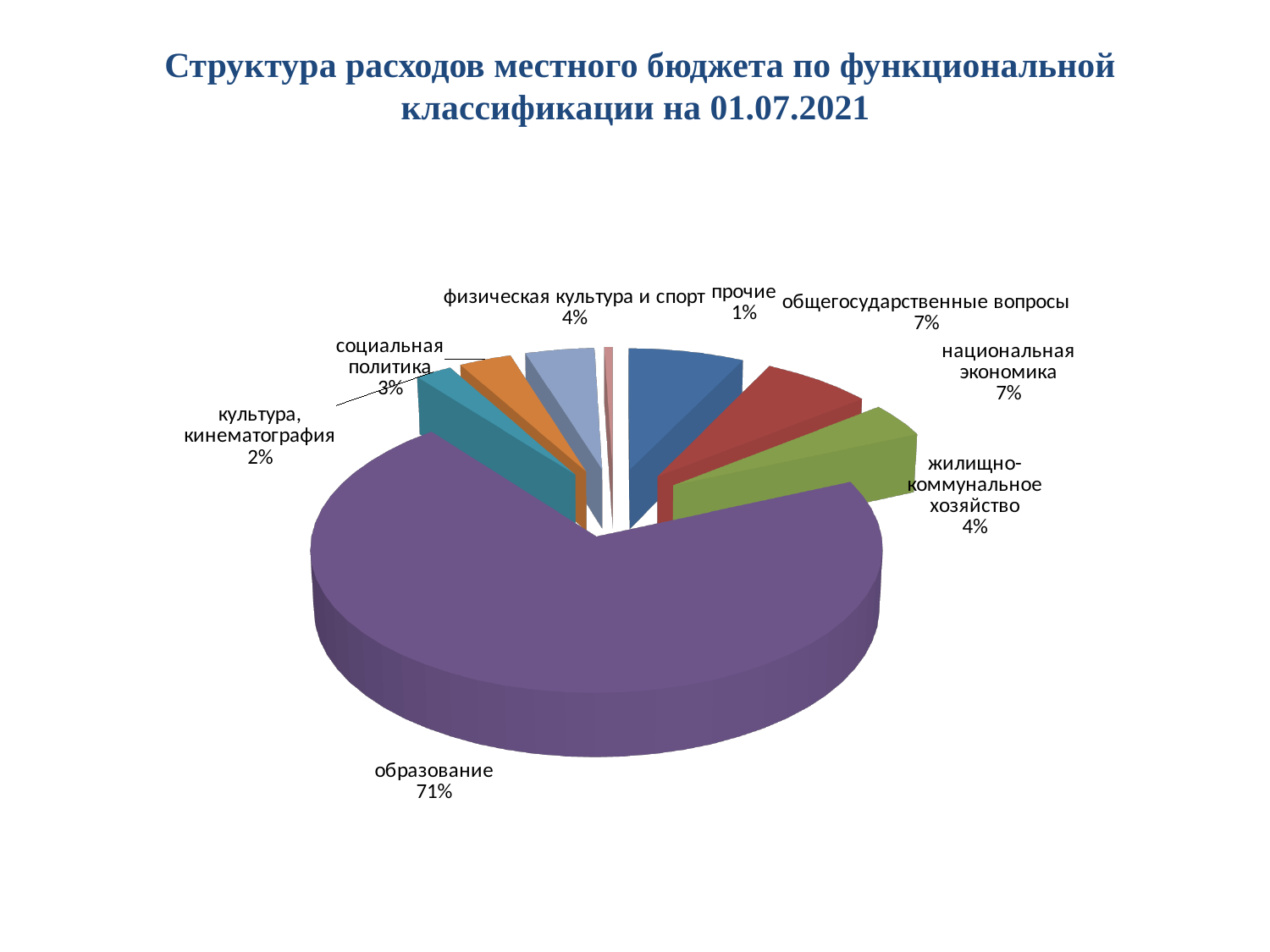
What is the difference in percentage points between образование and национальная экономика? 64 Which category has the largest share of the pie? образование What share of expenditures goes to социальная политика? 3% What is the title of the slide? Структура расходов местного бюджета по функциональной классификации на 01.07.2021 What share of expenditures goes to общегосударственные вопросы? 7% What share of expenditures goes to прочие? 1% Which category has the smallest share of the pie? прочие Which is larger: the share for физическая культура и спорт or the share for культура, кинематография? физическая культура и спорт How many categories are shown in the pie chart? 8 What share of expenditures goes to жилищно-коммунальное хозяйство? 4% What share of expenditures goes to образование? 71% What type of chart is shown on the slide? pie chart